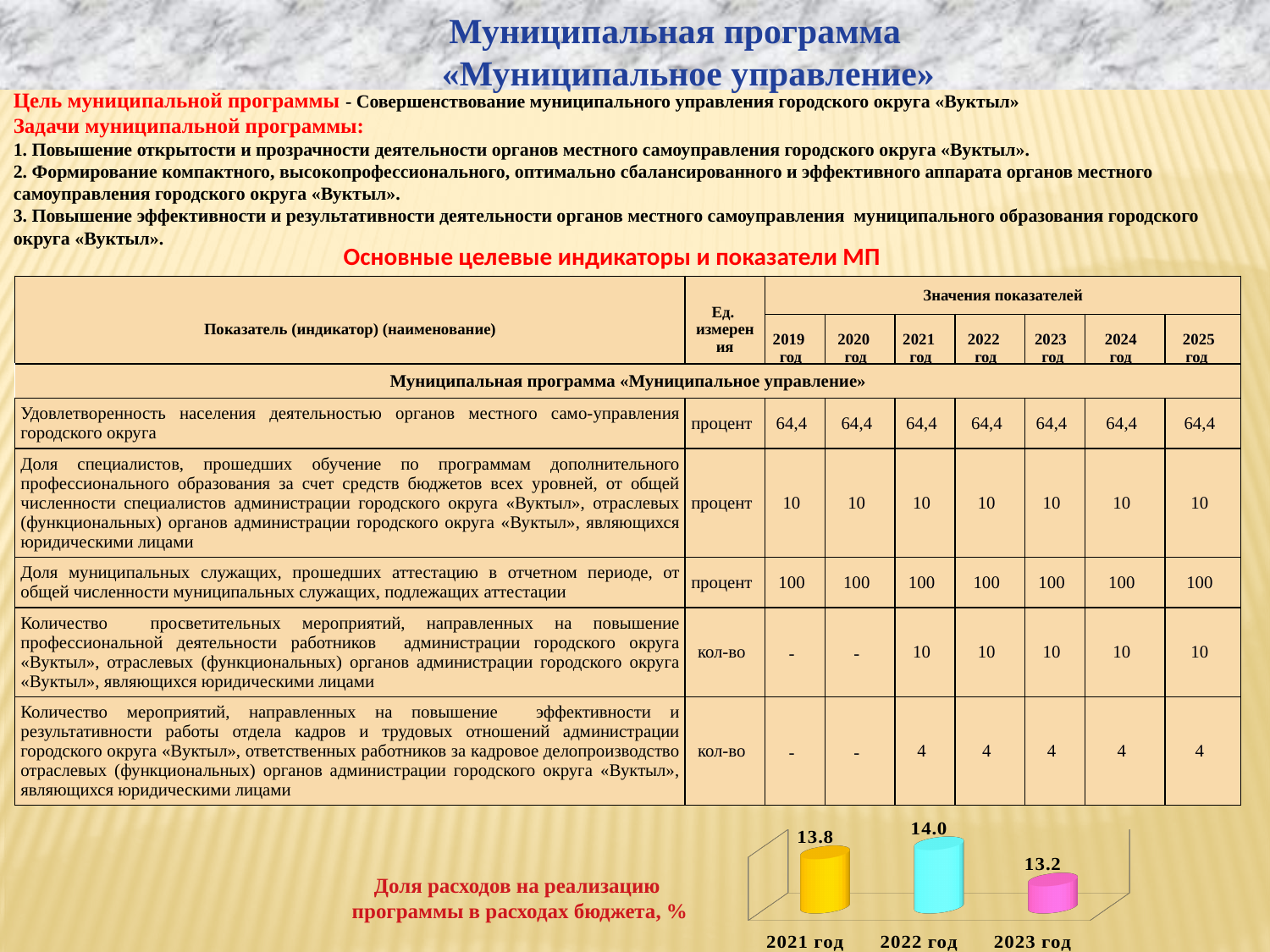
What does the chart at the bottom of the slide show, according to the text next to it? Доля расходов на реализацию программы в расходах бюджета, % What is the value for 2023 год in the chart at the bottom of the slide? 13.2 How many years (categories) are shown in the chart at the bottom of the slide? 3 In the chart at the bottom of the slide, which is larger: the value for 2021 год or the value for 2023 год? 2021 год Which year has the lowest value in the chart at the bottom of the slide? 2023 год What is the difference between the values for 2021 год and 2023 год in the chart at the bottom of the slide? 0.6 In the chart at the bottom of the slide, does the value rise or fall from 2022 год to 2023 год? fall Which year has the highest value in the chart at the bottom of the slide? 2022 год What is the value for 2022 год in the chart at the bottom of the slide? 14.0 What is the difference between the values for 2022 год and 2023 год in the chart at the bottom of the slide? 0.8 What is the value for 2021 год in the chart at the bottom of the slide? 13.8 What kind of chart is shown at the bottom of the slide? bar chart